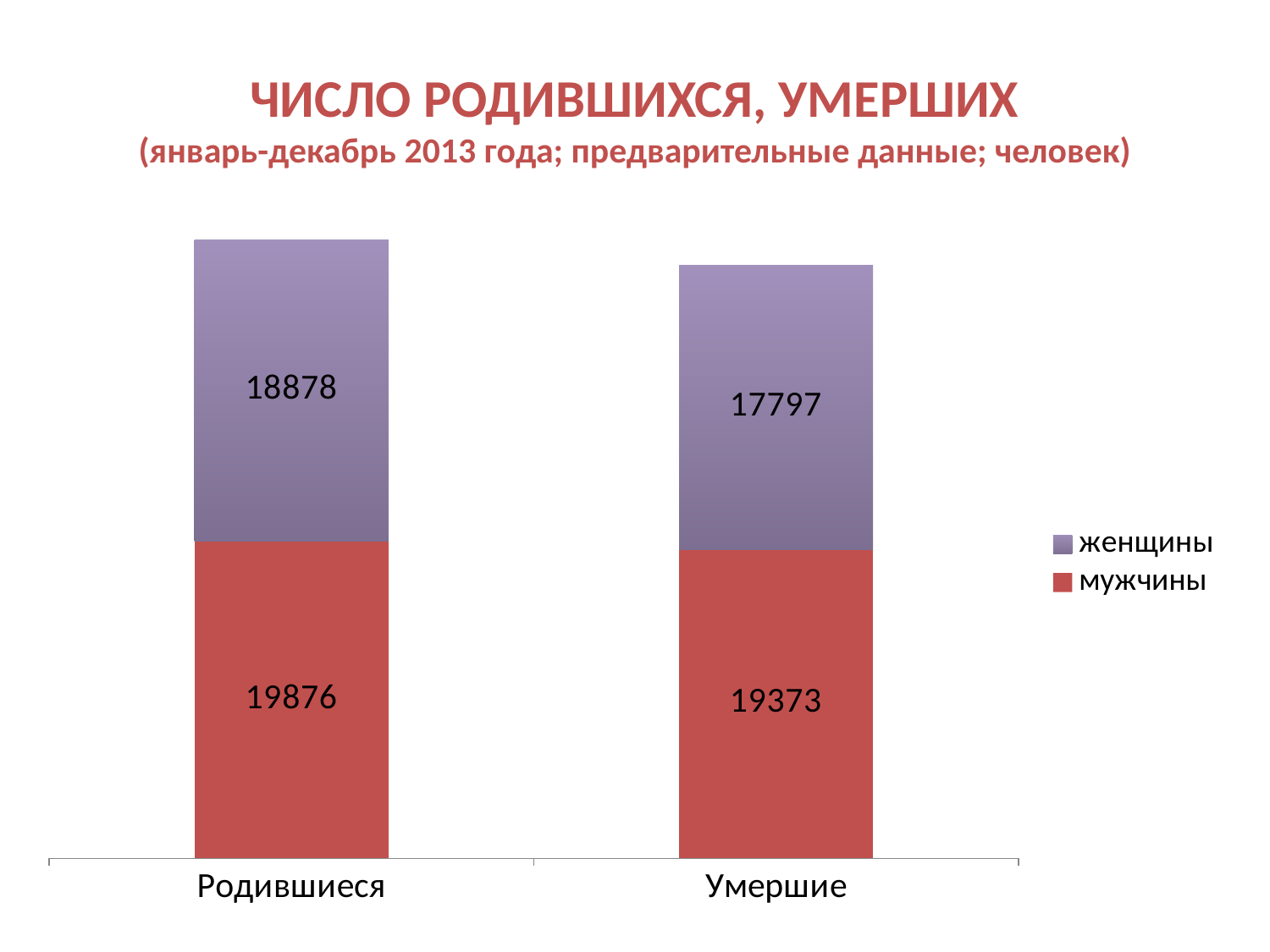
How many series does the legend list? 2 What is the total of the stacked bar for Родившиеся? 38754 What is the difference between the мужчины values for Родившиеся and Умершие? 503 What is the difference between the женщины values for Родившиеся and Умершие? 1081 Which is larger in the Умершие category: мужчины or женщины? мужчины What is the value for женщины in the Умершие category? 17797 What is the total of the stacked bar for Умершие? 37170 What is the value for женщины in the Родившиеся category? 18878 What is the value for мужчины in the Родившиеся category? 19876 How many categories are shown on the x axis? 2 What kind of chart is shown on the slide? stacked bar chart What is the value for мужчины in the Умершие category? 19373